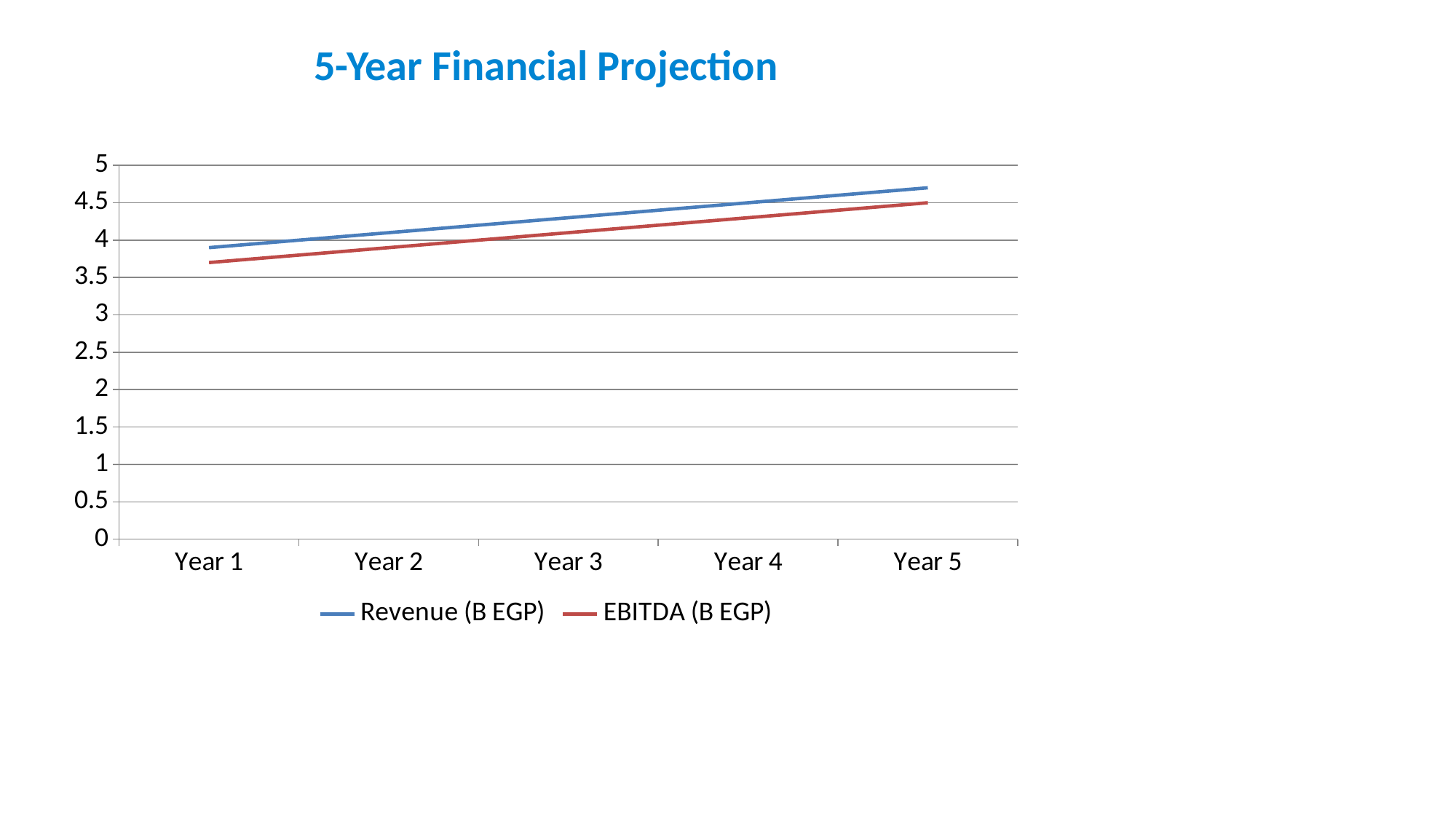
What kind of chart is shown on the slide? line chart Is the EBITDA (B EGP) value for Year 1 greater or less than 4? less Is the Revenue (B EGP) value for Year 3 greater or less than 4? greater How many series does the legend list? 2 Is the Revenue (B EGP) value for Year 5 greater or less than 4.5? greater In which year is EBITDA (B EGP) lowest? Year 1 In which year is Revenue (B EGP) highest? Year 5 Which colour is used for the EBITDA (B EGP) line? red How many years are plotted along the x axis? 5 Do the Revenue (B EGP) values rise or fall from Year 1 to Year 5? rise What is the title of the chart? 5-Year Financial Projection In Year 1, which is higher: Revenue (B EGP) or EBITDA (B EGP)? Revenue (B EGP)